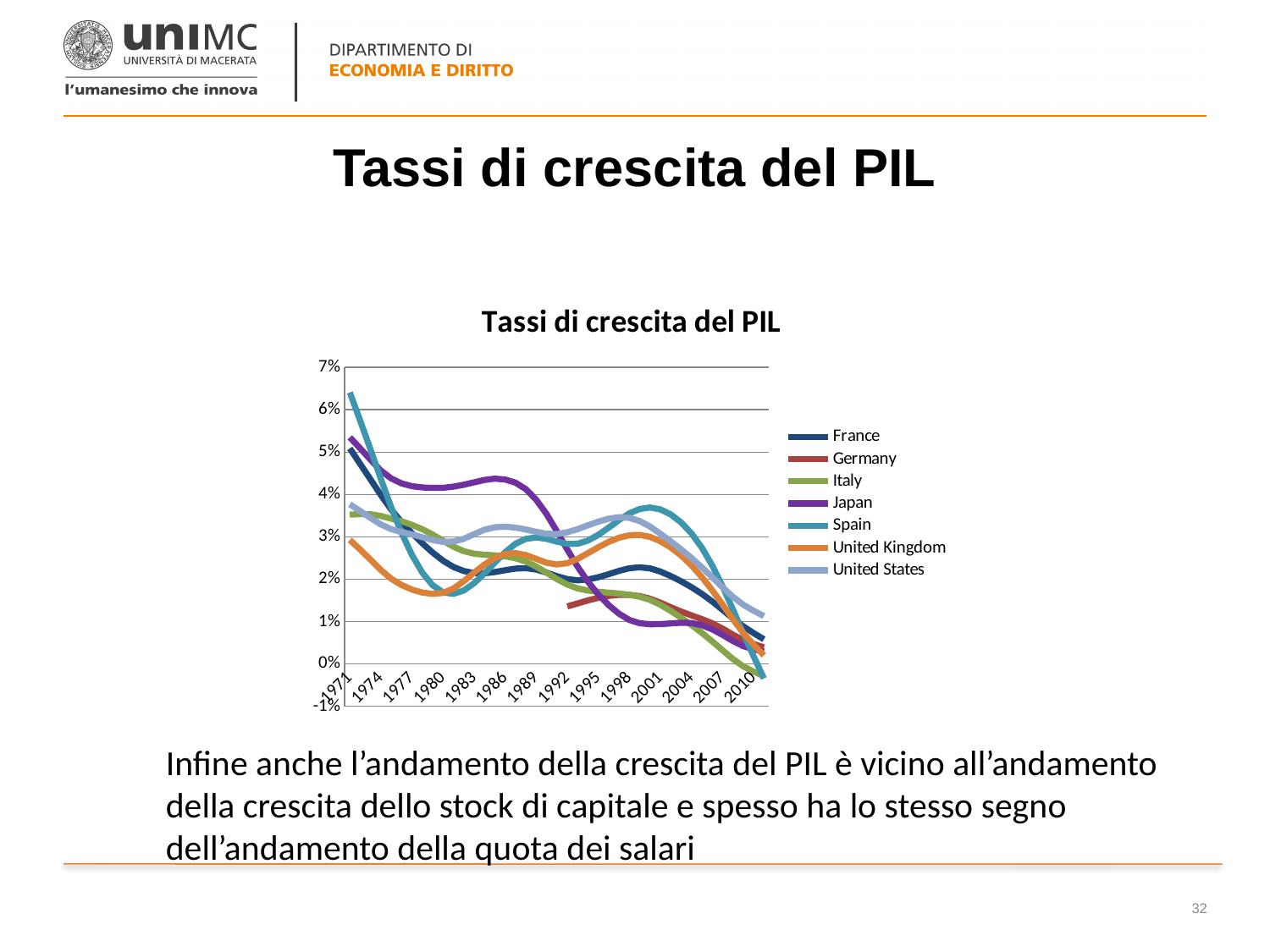
Around 1980, which is larger: the value for Japan or the value for Italy? Japan Which country has the lowest GDP growth rate in 1971 among the series plotted at that year? United Kingdom Which country has the highest GDP growth rate at the start of the series in 1971? Spain What kind of chart is shown on the slide? line chart Is the value for Spain in 1971 greater or less than 6%? greater In 1971, which is larger: the value for Spain or the value for the United Kingdom? Spain Is the value for France in 1971 greater or less than 4%? greater Does the France line generally rise or fall from 1971 to 2010? fall Is the value for Italy in 2010 greater or less than 1%? less What is the title of the chart? Tassi di crescita del PIL How many series does the legend list? 7 How many year labels are shown on the x axis? 14